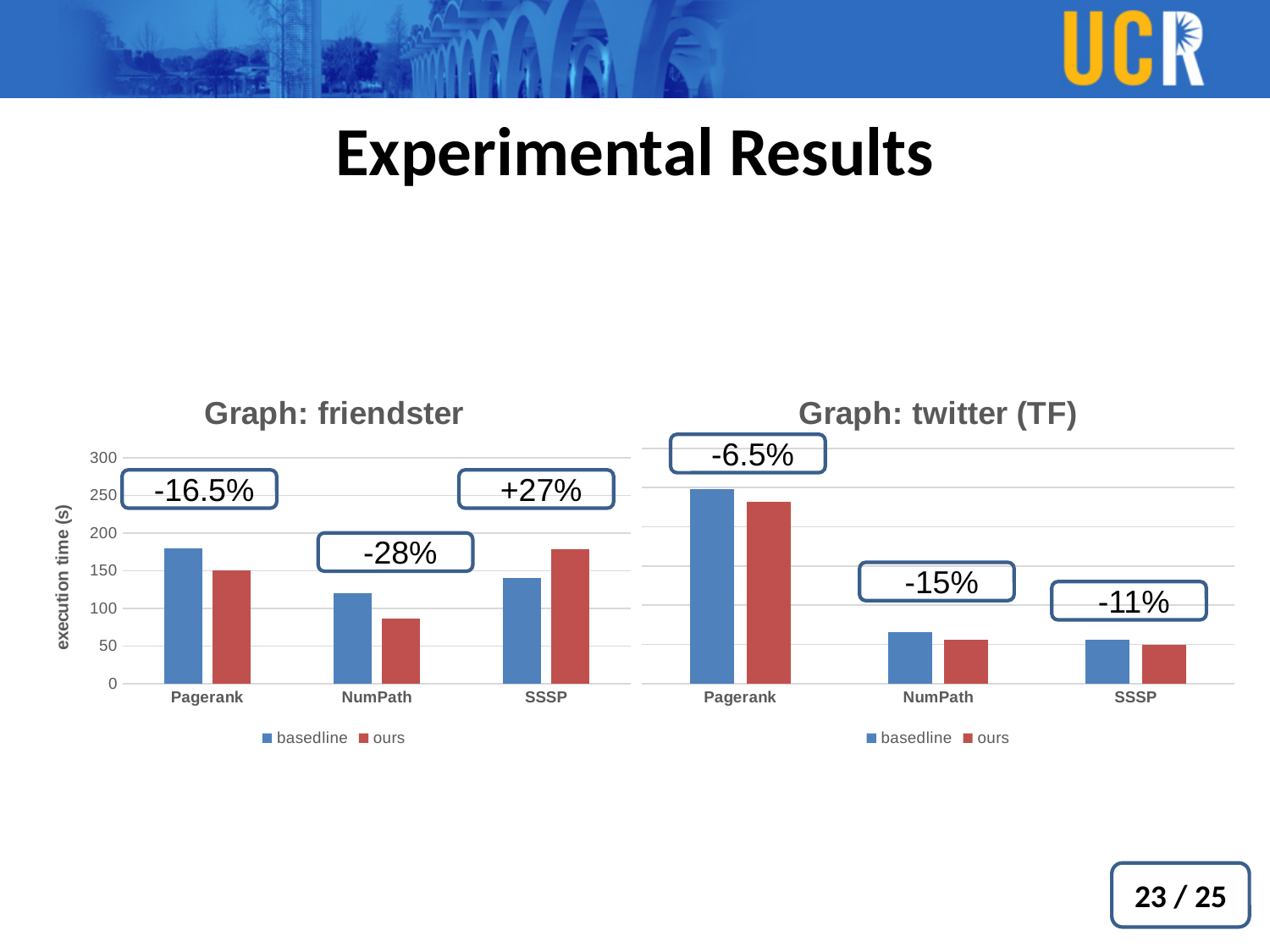
What is the y-axis label of the 'Graph: friendster' chart? execution time (s) In the 'Graph: friendster' chart, what percentage change is annotated above NumPath? -28% In the 'Graph: friendster' chart, for SSSP, which is larger: basedline or ours? ours How many categories are shown on the x axis of the 'Graph: twitter (TF)' chart? 3 How many series does the legend of the 'Graph: friendster' chart list? 2 In the 'Graph: twitter (TF)' chart, what percentage change is annotated above Pagerank? -6.5% In the 'Graph: twitter (TF)' chart, what percentage change is annotated above SSSP? -11% What type of chart is used for 'Graph: friendster'? bar chart In the 'Graph: friendster' chart, what percentage change is annotated above SSSP? +27% In the 'Graph: friendster' chart, is the basedline value for NumPath greater or less than 100? greater In the 'Graph: friendster' chart, which category has the highest basedline execution time? Pagerank In the 'Graph: twitter (TF)' chart, which category has the lowest 'ours' execution time? SSSP